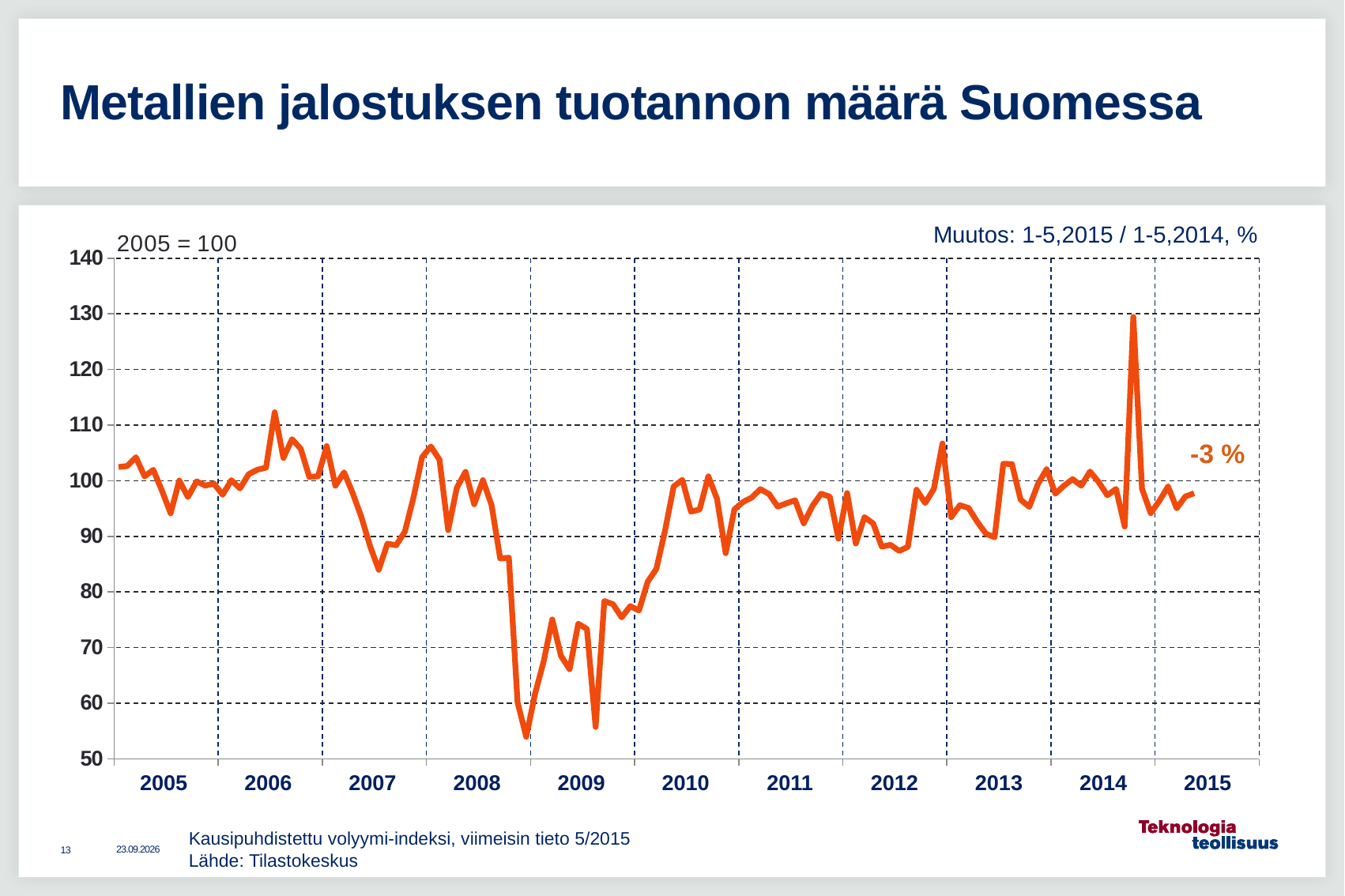
Is the highest value of the index, the spike in 2014, greater or less than 120? greater Is the peak value of the index in 2006 greater or less than 100? greater Does the index rise or fall between early 2009 and early 2010? rise What is the change shown for 1-5,2015 / 1-5,2014 on the chart? -3 % Does the index rise or fall between the start of 2008 and the end of 2008? fall What kind of chart is shown on the slide? line chart What base year note is printed above the y axis of the chart? 2005 = 100 What is the title of the chart on the slide? Metallien jalostuksen tuotannon määrä Suomessa How many lines are plotted on the chart? 1 How many year labels are shown on the x axis of the chart? 11 Is the lowest value of the index, reached in late 2008, greater or less than 60? less